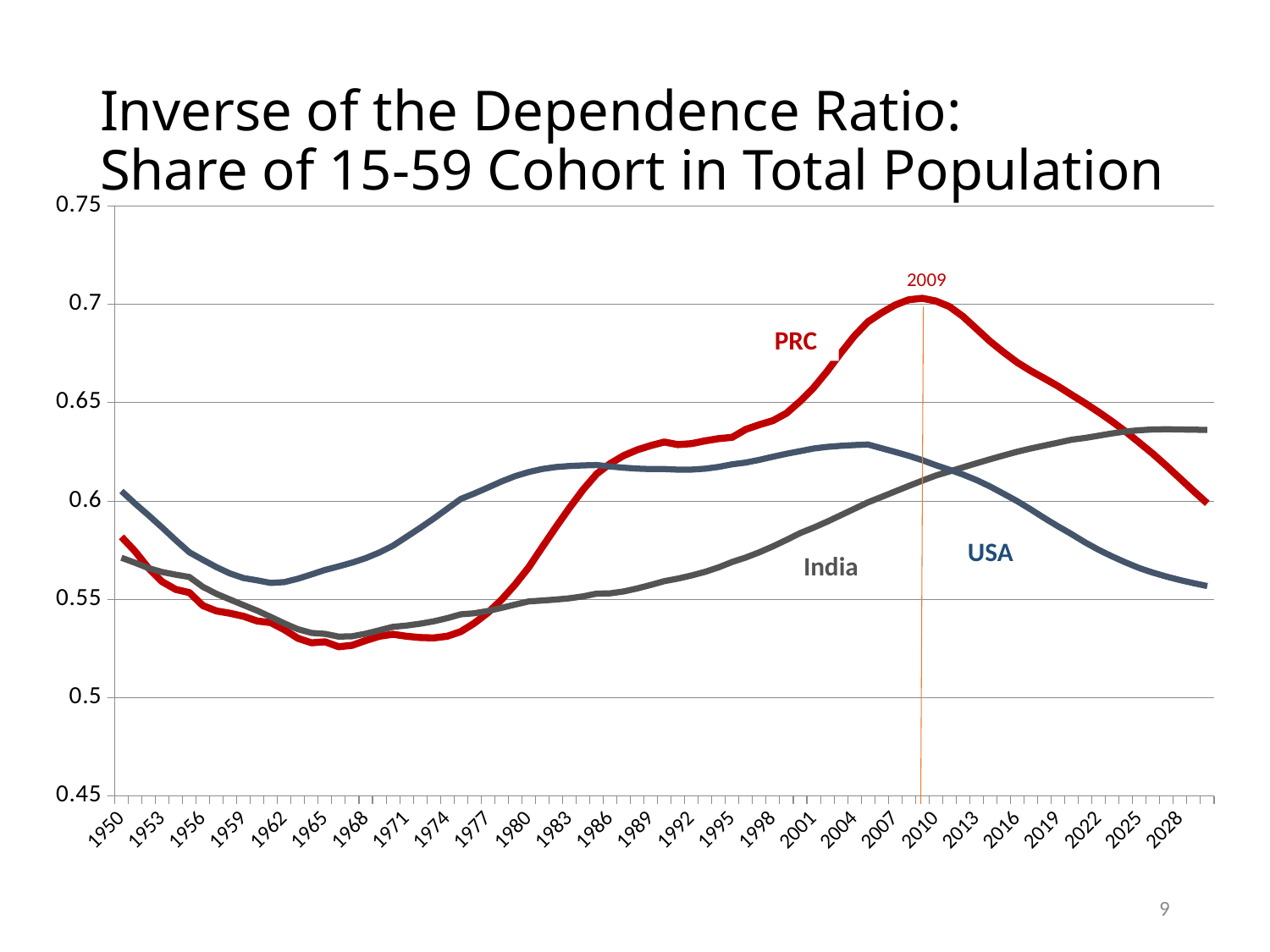
Does the India line rise or fall from 1980 to 2028? rise Which year is marked by the vertical line and annotation on the chart? 2009 Does the PRC line rise or fall from 2009 to 2028? fall Is the value for USA in 2028 greater or less than 0.6? less Is the value for India in 1950 greater or less than 0.6? less Is the value for USA in 2004 greater or less than 0.6? greater Which series reaches the highest value anywhere on the chart? PRC How many series (countries) are plotted on the chart? 3 What kind of chart is shown on the slide? line chart In 1950, which series has the higher value, USA or PRC? USA In 2028, which series has the higher value, India or USA? India